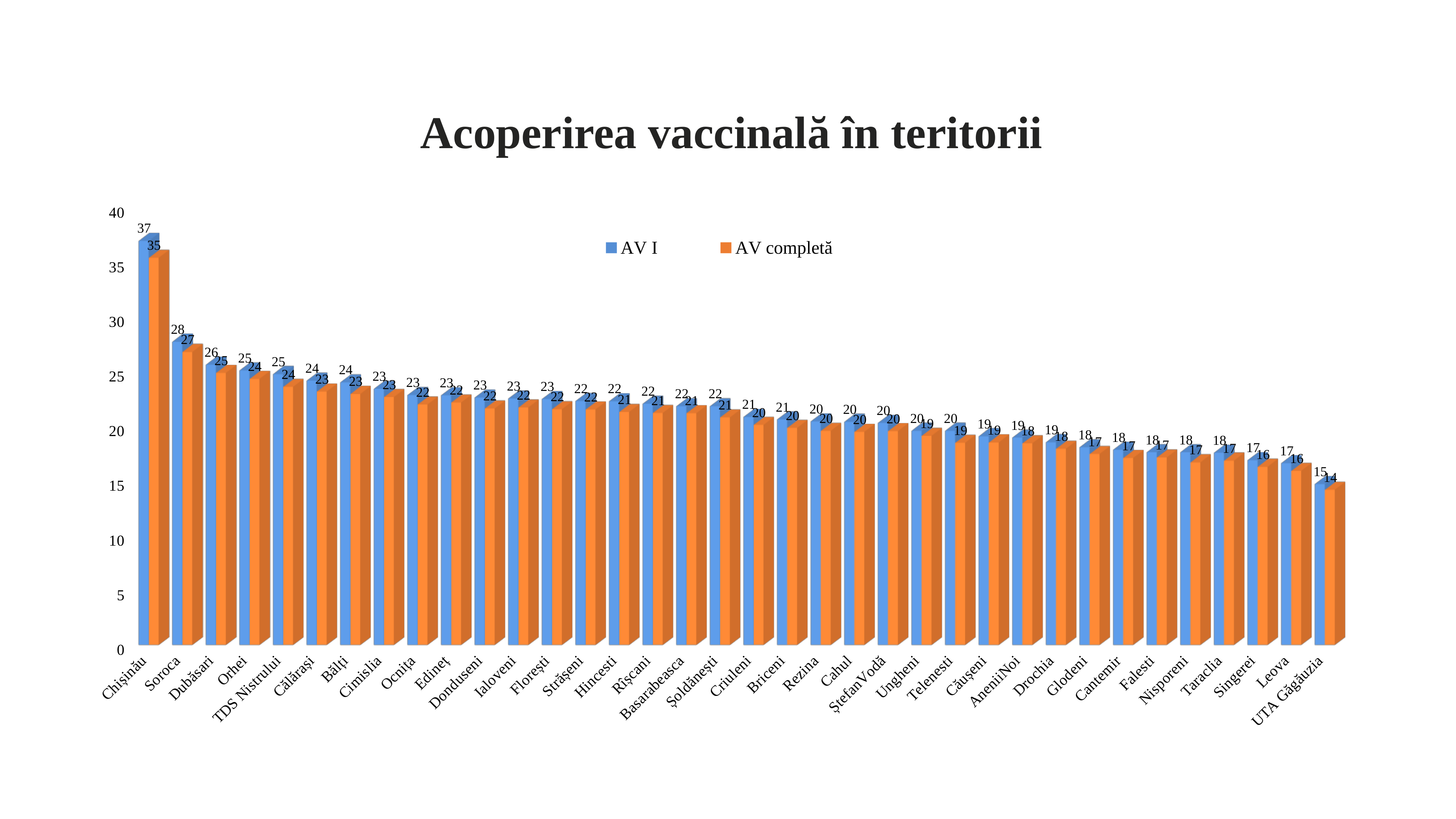
What is the AV completă value for Soroca? 27 Which territory has the highest AV I value? Chișinău What kind of chart is shown on the slide? bar chart What is the AV completă value for UTA Găgăuzia? 14 How many territories are shown on the x axis? 36 How many series does the legend list? 2 Which is larger, the AV I value for Soroca or the AV I value for Dubăsari? Soroca Which territory has the lowest AV completă value? UTA Găgăuzia Do the AV I values rise or fall from left to right along the x axis? fall What is the AV I value for Chișinău? 37 Is the AV I value for Chișinău greater or less than 35? greater What is the difference between the AV I and AV completă values for Chișinău? 2